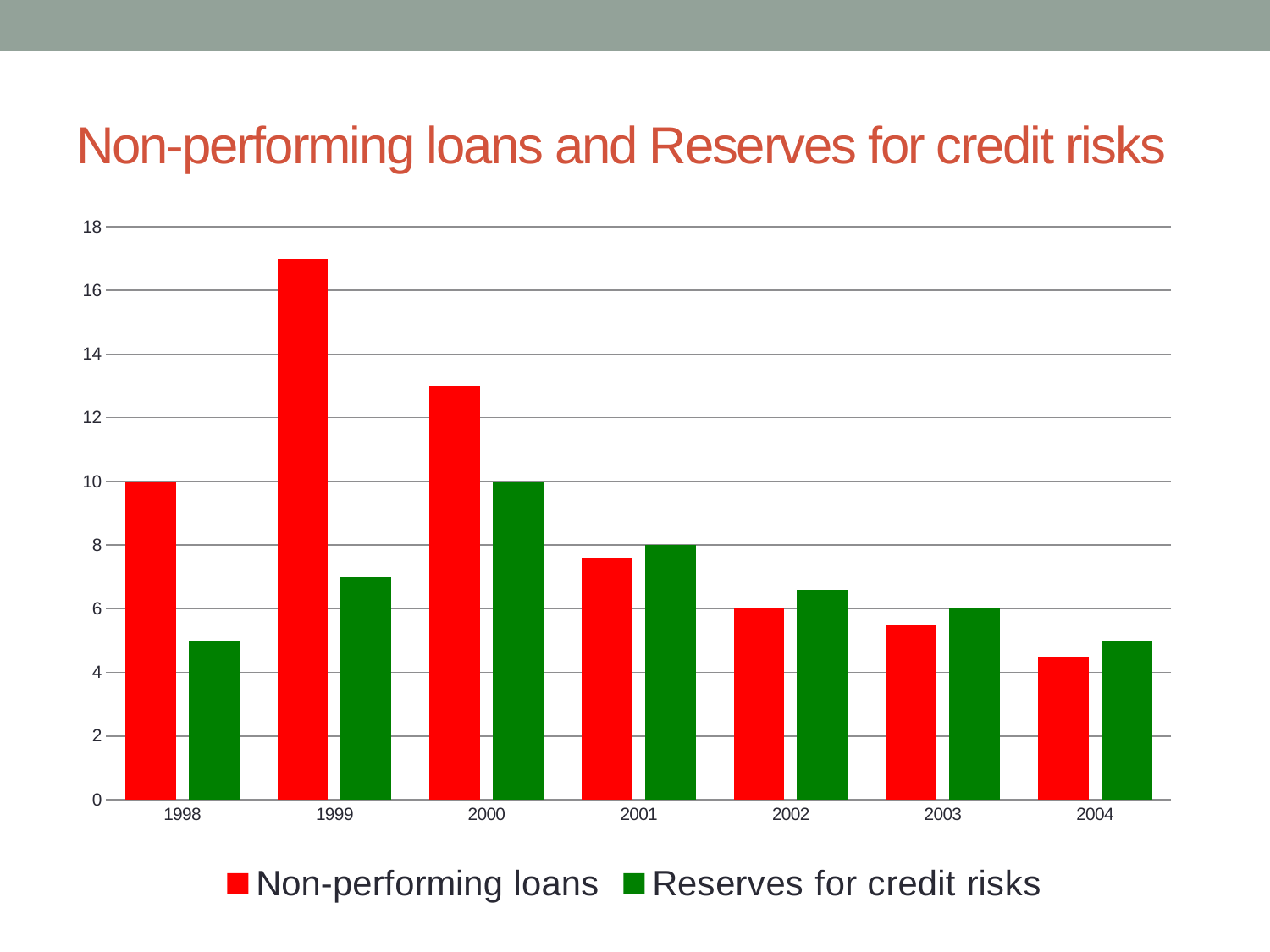
What is the value of Reserves for credit risks in 2001? 8 What is the value of Reserves for credit risks in 2000? 10 How many years are shown on the x axis? 7 What type of chart is shown on the slide? Bar chart Is the value for Non-performing loans in 2004 greater or less than 6? less How many series does the legend list? 2 In which year are Non-performing loans lowest? 2004 Is the value for Non-performing loans in 1999 greater or less than 16? greater In 2002, which is larger: Non-performing loans or Reserves for credit risks? Reserves for credit risks What is the value of Non-performing loans in 2002? 6 What is the value of Non-performing loans in 1998? 10 In which year are Non-performing loans highest? 1999